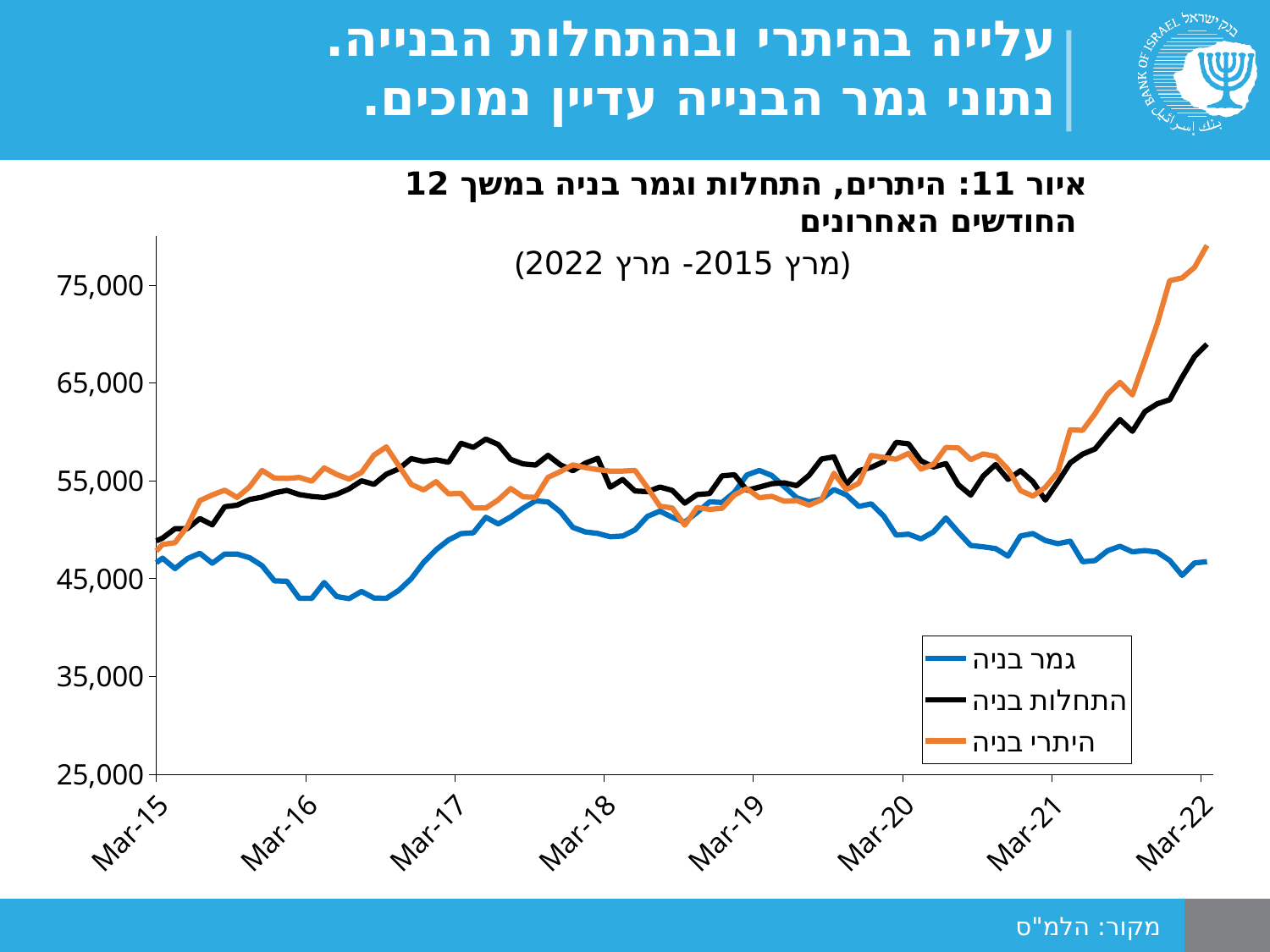
Is the value for גמר בניה at Mar-22 greater or less than 55,000? less What kind of chart is shown on the slide? line chart Between Mar-20 and Mar-22, does the גמר בניה line rise or fall? fall At Mar-22, which is larger: היתרי בניה or התחלות בניה? היתרי בניה Which series has the lowest value at Mar-22? גמר בניה What are the three series listed in the legend? גמר בניה, התחלות בניה, היתרי בניה Between Mar-21 and Mar-22, does the היתרי בניה line rise or fall? rise Is the value for היתרי בניה at Mar-22 greater or less than 75,000? greater How many labelled tick marks are on the x axis? 8 How many series does the legend list? 3 Is the value for התחלות בניה at Mar-22 greater or less than 65,000? greater Which series has the highest value at Mar-22? היתרי בניה